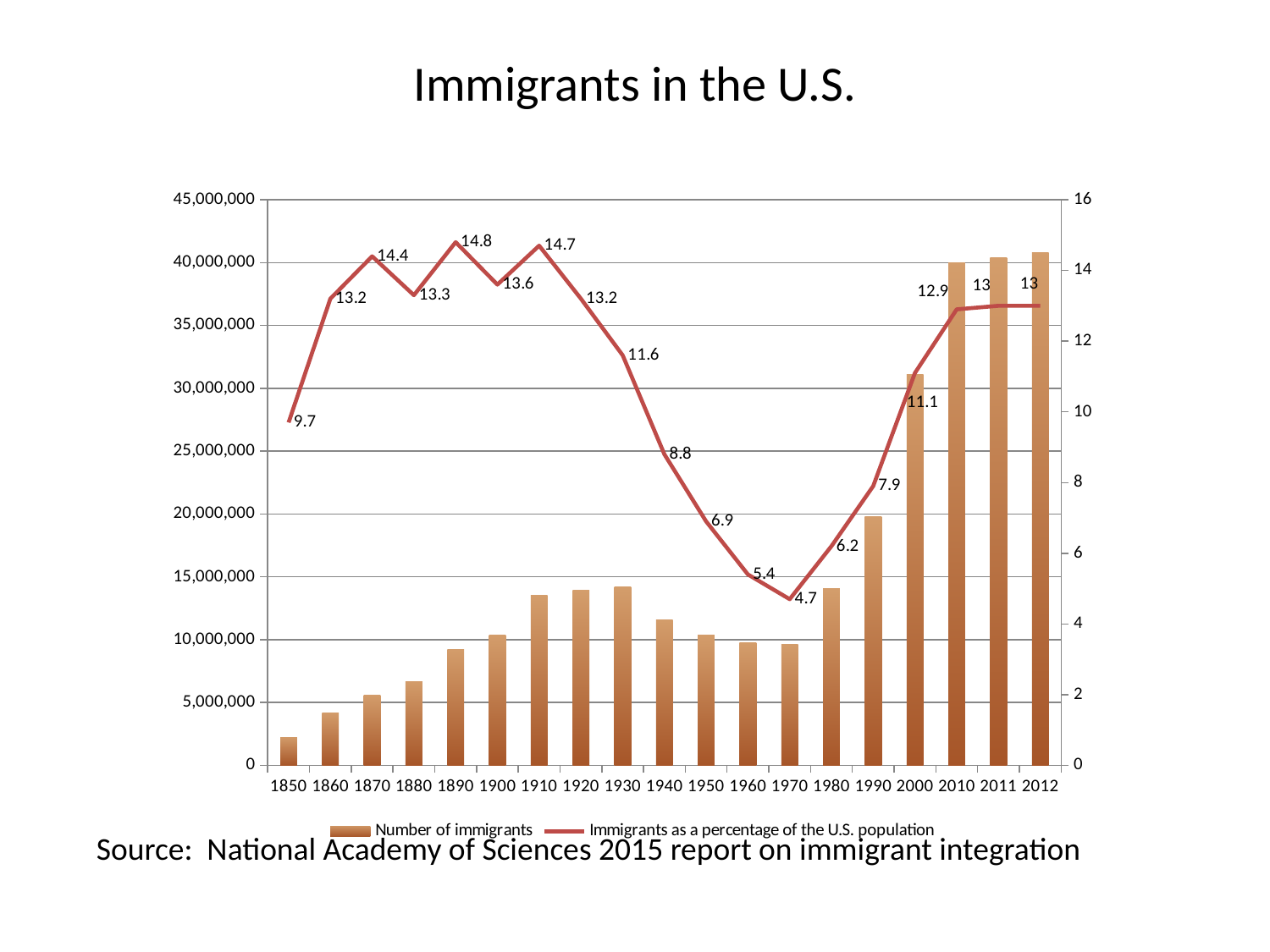
Is the number of immigrants in 2010 greater or less than 35,000,000? greater In which year was the immigrant percentage of the U.S. population highest? 1890 What was the percentage of immigrants in the U.S. population in 2000? 11.1 What was the percentage of immigrants in the U.S. population in 1970? 4.7 What was the percentage of immigrants in the U.S. population in 1890? 14.8 How many series does the legend list? 2 What is the difference between the immigrant percentage in 1910 and in 1970? 10 What kind of chart is shown on the slide? Combination bar and line chart Which year had a higher immigrant percentage of the U.S. population, 1940 or 1990? 1940 In which year was the immigrant percentage of the U.S. population lowest? 1970 Is the number of immigrants in 1850 greater or less than 5,000,000? less How many years are shown on the x axis? 19